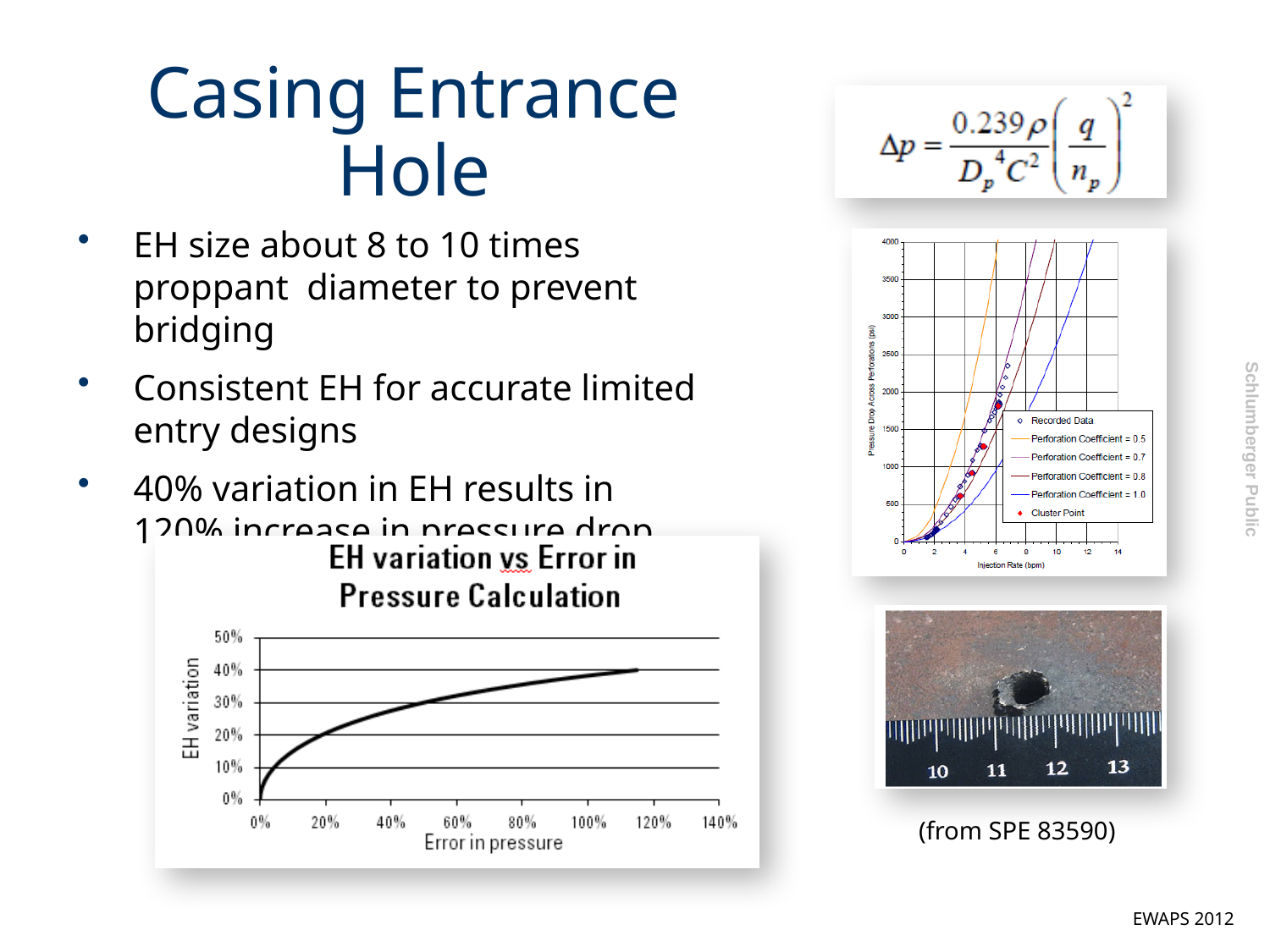
In the pressure drop vs injection rate chart on the right, what is the label of the x axis? Injection Rate (bpm) In the 'EH variation vs Error in Pressure Calculation' chart, what is the label of the x axis? Error in pressure In the pressure drop vs injection rate chart on the right, which perforation coefficient curve gives the lowest pressure drop at an injection rate of 10 bpm? Perforation Coefficient = 1.0 In the 'EH variation vs Error in Pressure Calculation' chart, is the EH variation at 100% error in pressure greater or less than 30%? greater In the pressure drop vs injection rate chart on the right, at an injection rate of 6 bpm, is the pressure drop for the Perforation Coefficient = 1.0 curve greater or less than 1500 psi? less In the 'EH variation vs Error in Pressure Calculation' chart, what is the highest value shown on the y axis? 50% In the pressure drop vs injection rate chart on the right, which perforation coefficient curve reaches 4000 psi at the lowest injection rate? Perforation Coefficient = 0.5 In the 'EH variation vs Error in Pressure Calculation' chart, is the EH variation at 10% error in pressure greater or less than 20%? less In the 'EH variation vs Error in Pressure Calculation' chart, does EH variation rise or fall as error in pressure increases? rise In the pressure drop vs injection rate chart on the right, at an injection rate of 4 bpm, which curve shows a larger pressure drop: Perforation Coefficient = 0.5 or Perforation Coefficient = 1.0? Perforation Coefficient = 0.5 What kind of chart is the 'EH variation vs Error in Pressure Calculation' chart? line chart How many entries does the legend of the pressure drop vs injection rate chart on the right list? 6